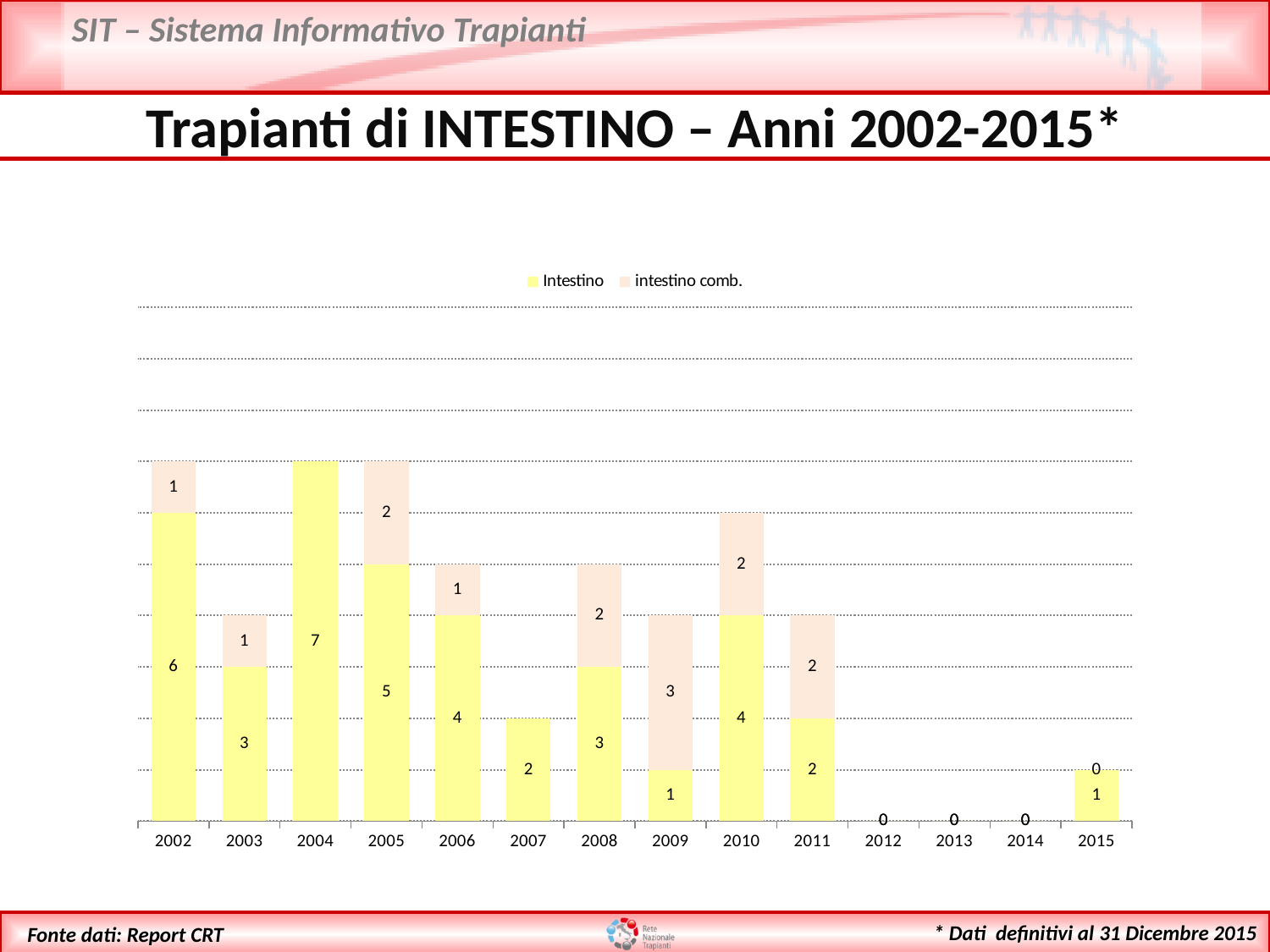
Which year has the highest value for Intestino? 2004 What is the total of the stacked bar for 2005? 7 What is the value of Intestino for 2002? 6 What type of chart is shown on the slide? stacked bar chart Which is larger, the Intestino value for 2006 or for 2008? 2006 What is the title of the slide containing the chart? Trapianti di INTESTINO – Anni 2002-2015* What is the value of intestino comb. for 2009? 3 How many series does the legend list? 2 What is the total of the stacked bar for 2010? 6 How many years are shown on the x axis? 14 What is the difference between the Intestino values for 2002 and 2003? 3 What is the value of Intestino for 2004? 7